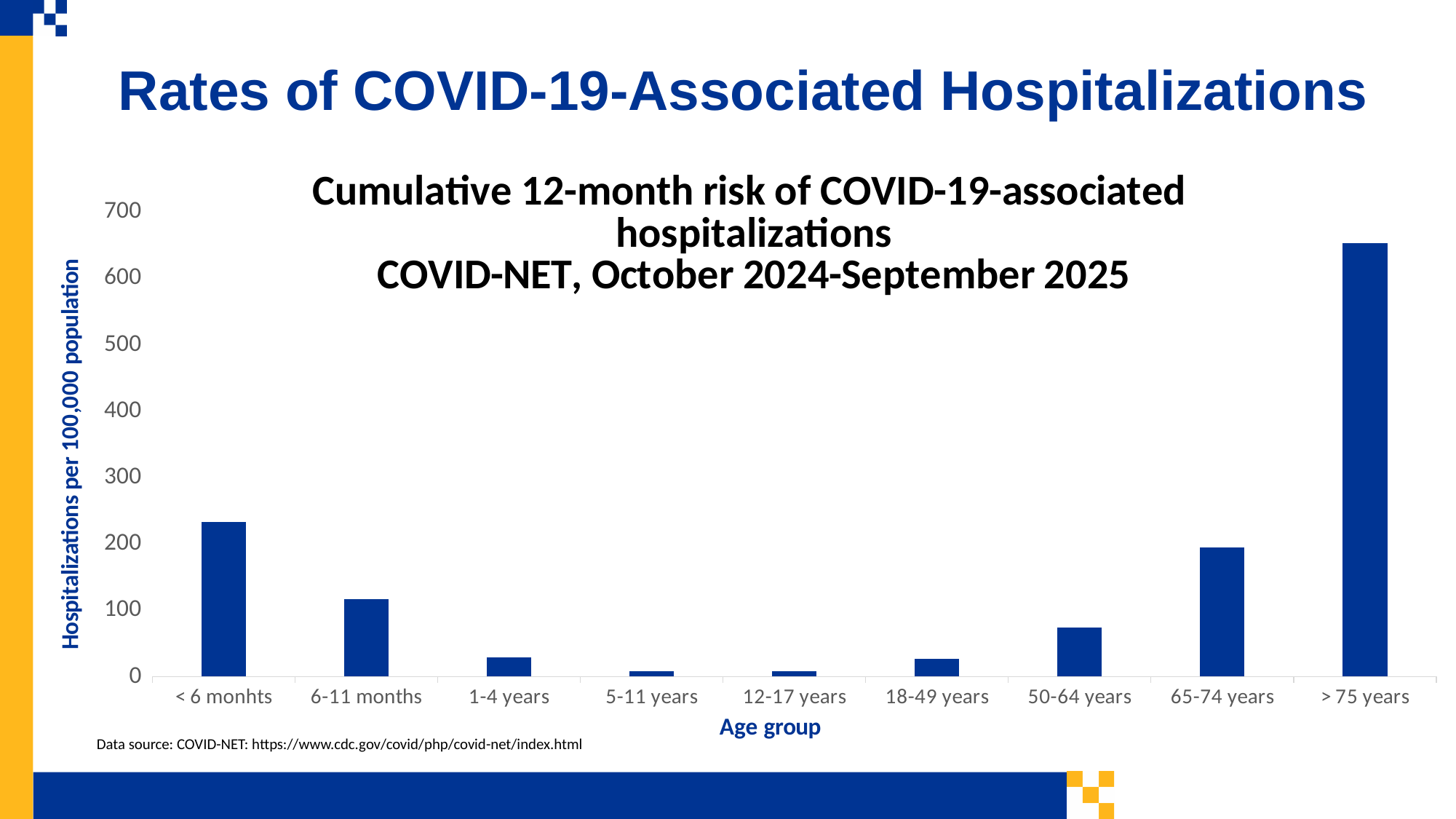
What kind of chart is shown on the slide? bar chart Which is larger, the value for 6-11 months or the value for 50-64 years? 6-11 months Is the value for < 6 monhts greater or less than 200? greater Is the value for 50-64 years greater or less than 100? less Which age group has the highest hospitalization rate? > 75 years Is the value for 6-11 months greater or less than 100? greater Which is larger, the value for < 6 monhts or the value for 65-74 years? < 6 monhts What is the label of the vertical axis? Hospitalizations per 100,000 population Do the values rise or fall from 18-49 years to > 75 years? rise How many age groups are plotted on the chart? 9